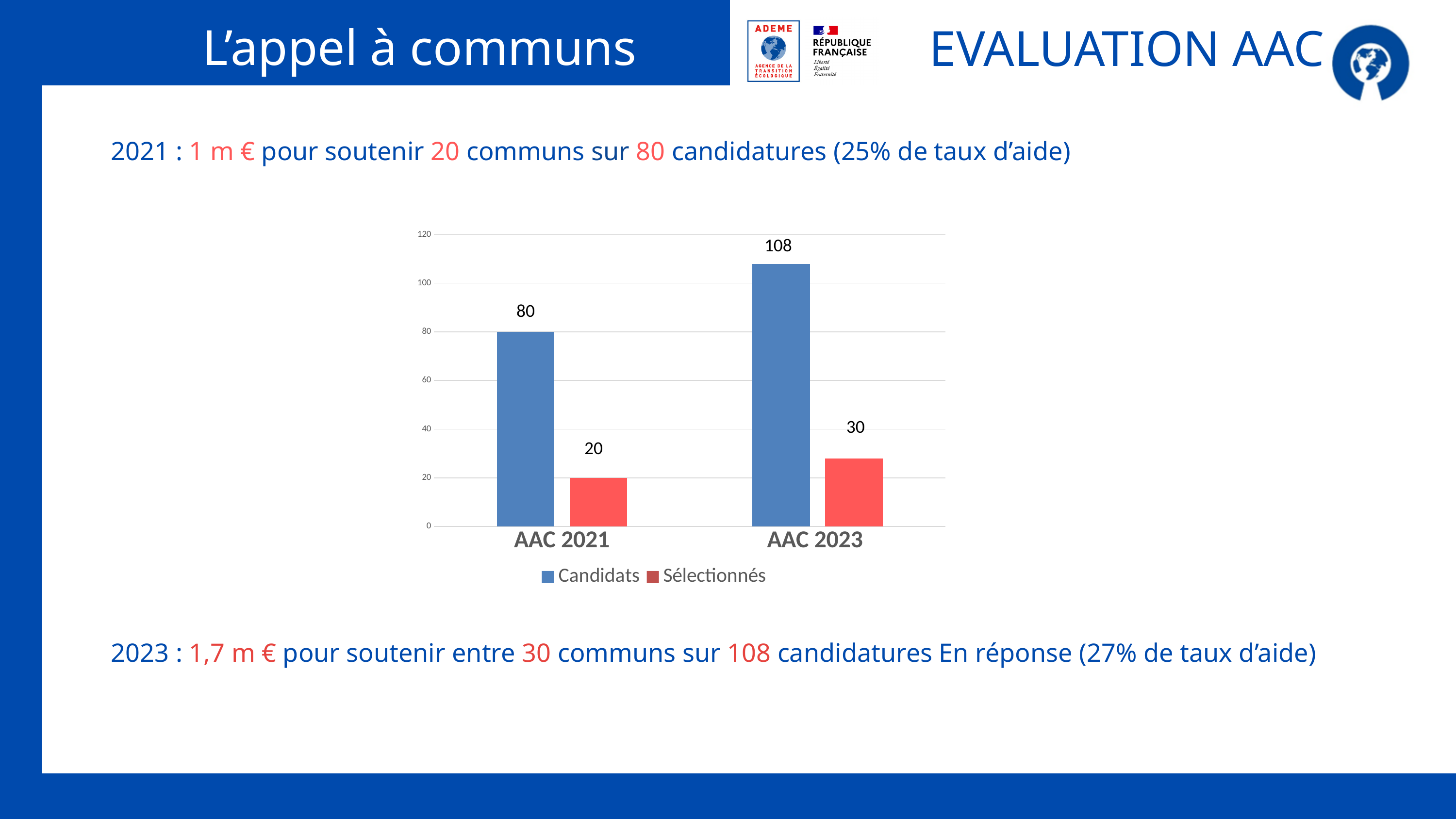
Is the value for Candidats in AAC 2023 greater or less than 100? greater How many series does the legend list? 2 What kind of chart is shown on the slide? bar chart What is the value for Candidats in AAC 2021? 80 What is the value for Candidats in AAC 2023? 108 What is the value for Sélectionnés in AAC 2021? 20 Which category has the lowest Sélectionnés value? AAC 2021 What is the value for Sélectionnés in AAC 2023? 30 Which category has the highest Candidats value? AAC 2023 How many categories are shown on the x axis? 2 Which is larger: Sélectionnés in AAC 2023 or Sélectionnés in AAC 2021? AAC 2023 What is the difference between Candidats in AAC 2023 and Candidats in AAC 2021? 28